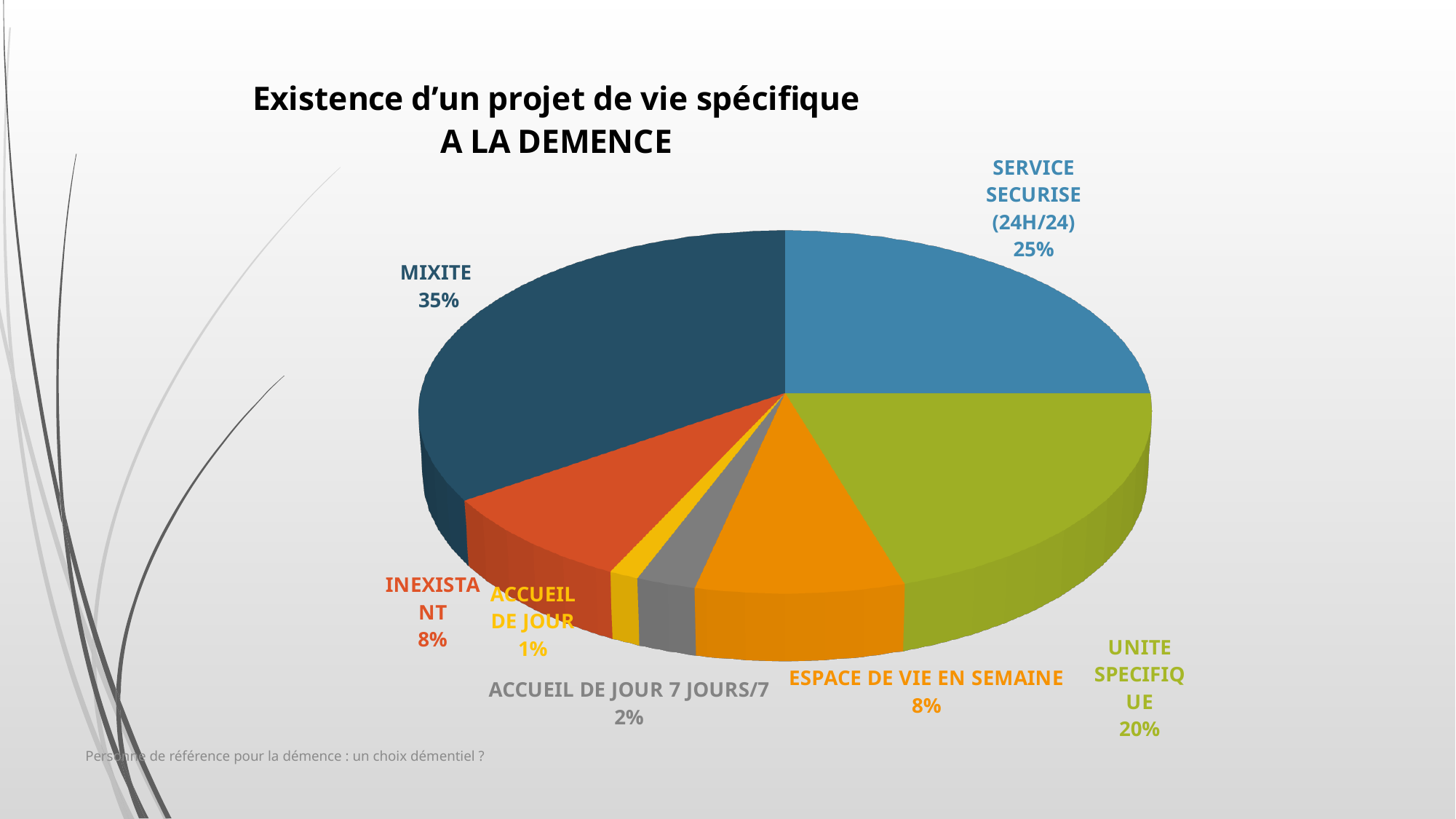
What percentage is shown for SERVICE SECURISE (24H/24)? 25% Which category has the smallest slice of the pie? ACCUEIL DE JOUR What is the difference in percentage points between MIXITE and SERVICE SECURISE (24H/24)? 10% What is the title of the chart? Existence d'un projet de vie spécifique A LA DEMENCE What colour is the MIXITE slice? Dark blue What percentage is shown for UNITE SPECIFIQUE? 20% How many slices does the pie chart have? 7 What kind of chart is shown on the slide? Pie chart Which is larger, UNITE SPECIFIQUE or INEXISTANT? UNITE SPECIFIQUE What share of the pie is MIXITE? 35% What percentage is shown for ACCUEIL DE JOUR 7 JOURS/7? 2% Which category has the largest slice of the pie? MIXITE